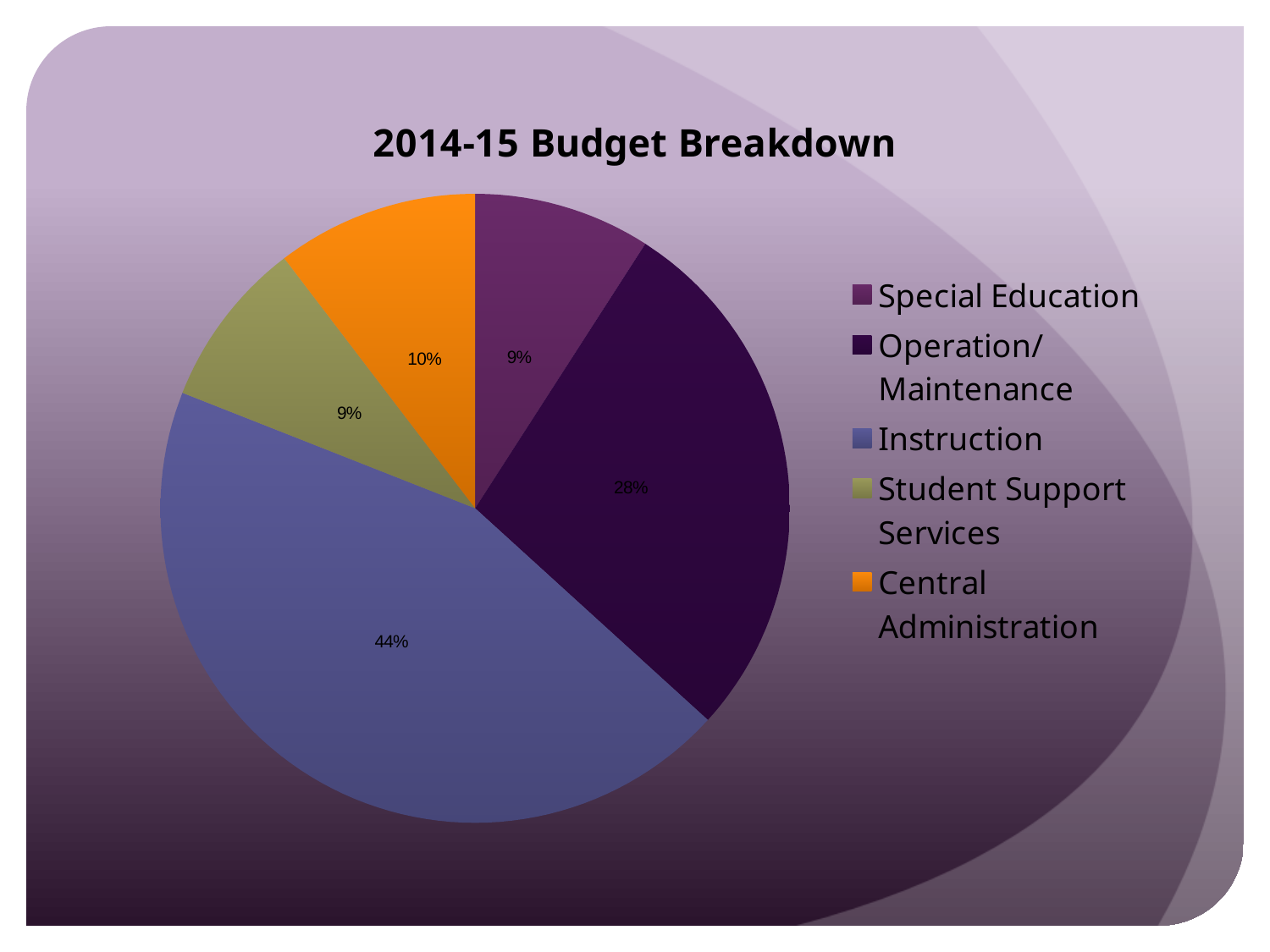
Which category has the largest share of the budget? Instruction What is the title of the chart? 2014-15 Budget Breakdown Which is larger, the share for Central Administration or the share for Special Education? Central Administration What share of the budget goes to Instruction? 44% What kind of chart is shown on the slide? pie chart What share of the budget goes to Central Administration? 10% What is the difference between the Instruction share and the Operation/Maintenance share? 16% What share of the budget goes to Operation/Maintenance? 28% How many categories does the legend list? 5 What colour is the Central Administration slice? orange